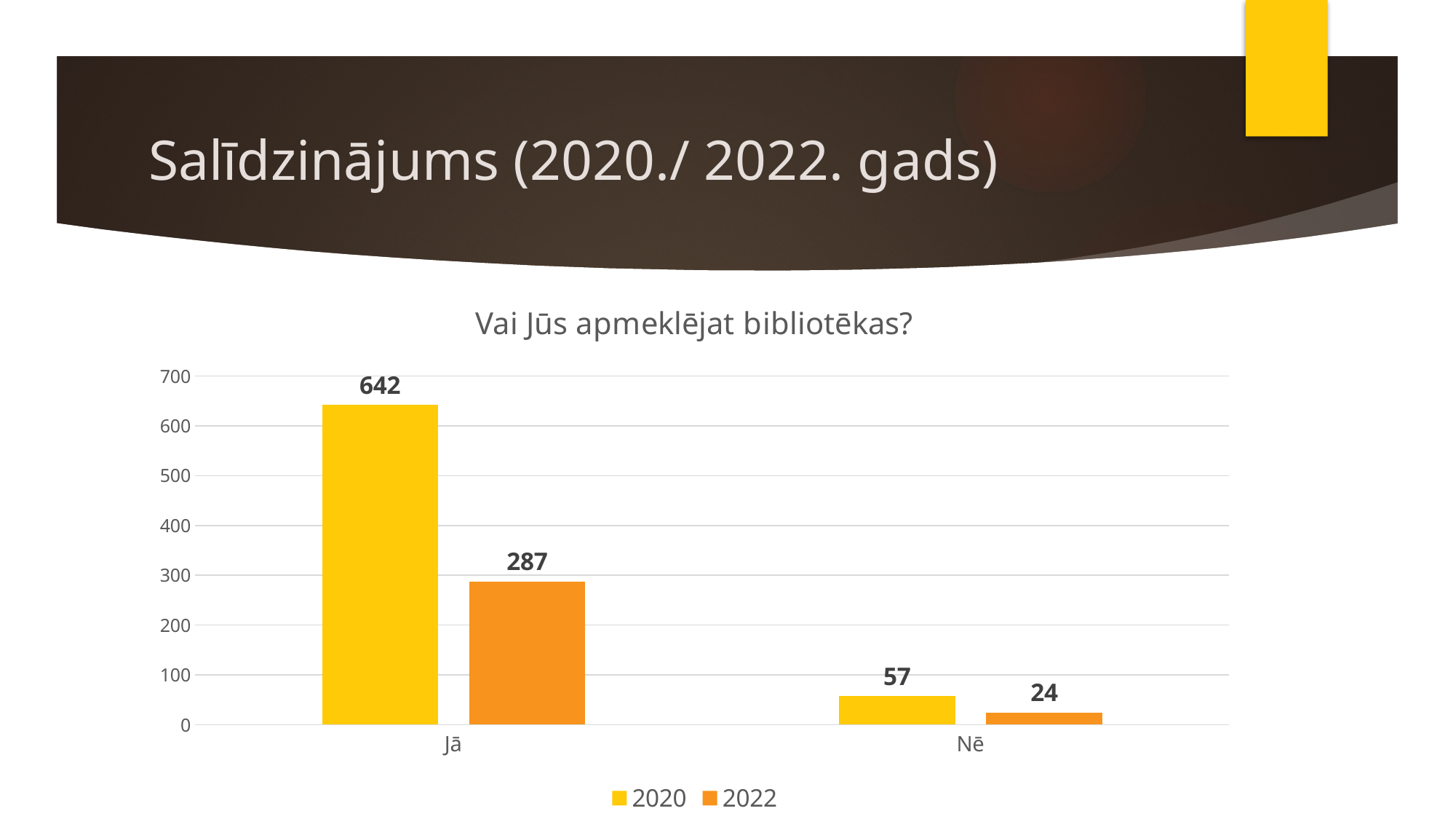
What is the value for 2020 in the "Nē" category? 57 Which bar has the lowest value on the chart? 2022, Nē Which is larger: the 2022 value for "Jā" or the 2020 value for "Nē"? 2022 value for Jā What is the value for 2022 in the "Jā" category? 287 What is the value for 2020 in the "Jā" category? 642 How many series does the legend list? 2 What is the difference between the 2020 and 2022 values for "Nē"? 33 How many categories are shown on the x axis? 2 Which bar has the highest value on the chart? 2020, Jā What is the difference between the 2020 and 2022 values for "Jā"? 355 What is the value for 2022 in the "Nē" category? 24 What type of chart is shown on the slide? Bar chart